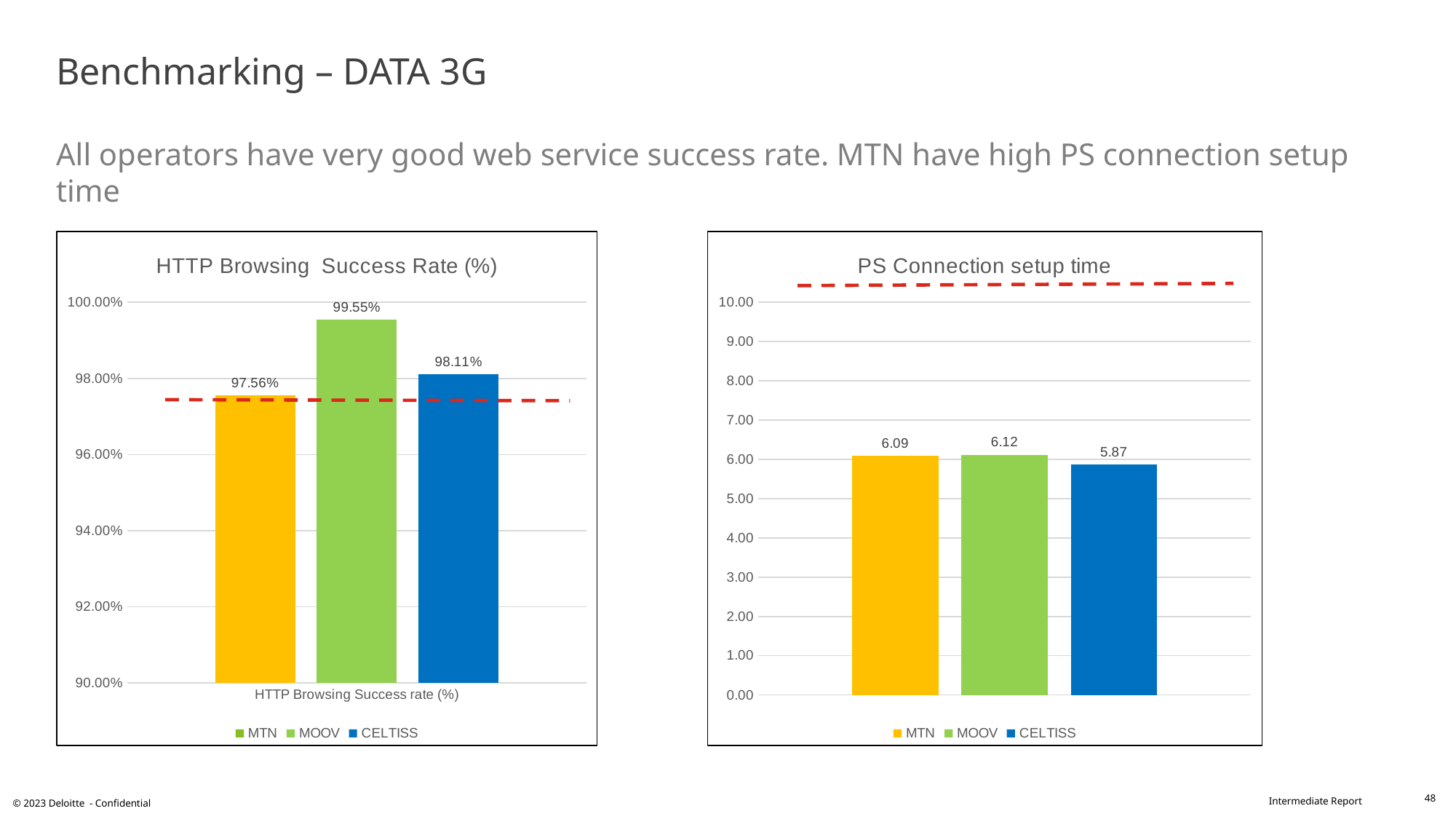
In the HTTP Browsing Success Rate (%) chart, what is the value for MTN? 97.56% In the PS Connection setup time chart, which operator has the lowest setup time? CELTISS In the HTTP Browsing Success Rate (%) chart, which operator has the highest success rate? MOOV In the PS Connection setup time chart, is the value for MOOV greater or less than 7.00? less In the PS Connection setup time chart, what is the value for MTN? 6.09 In the PS Connection setup time chart, which is larger, the value for MTN or the value for CELTISS? MTN In the HTTP Browsing Success Rate (%) chart, what is the value for MOOV? 99.55% In the PS Connection setup time chart, what is the value for CELTISS? 5.87 In the HTTP Browsing Success Rate (%) chart, which operator has the lowest success rate? MTN In the HTTP Browsing Success Rate (%) chart, what is the difference between the MOOV and CELTISS values? 1.44% What kind of chart is the HTTP Browsing Success Rate (%) chart? Bar chart How many series does the legend of the PS Connection setup time chart list? 3